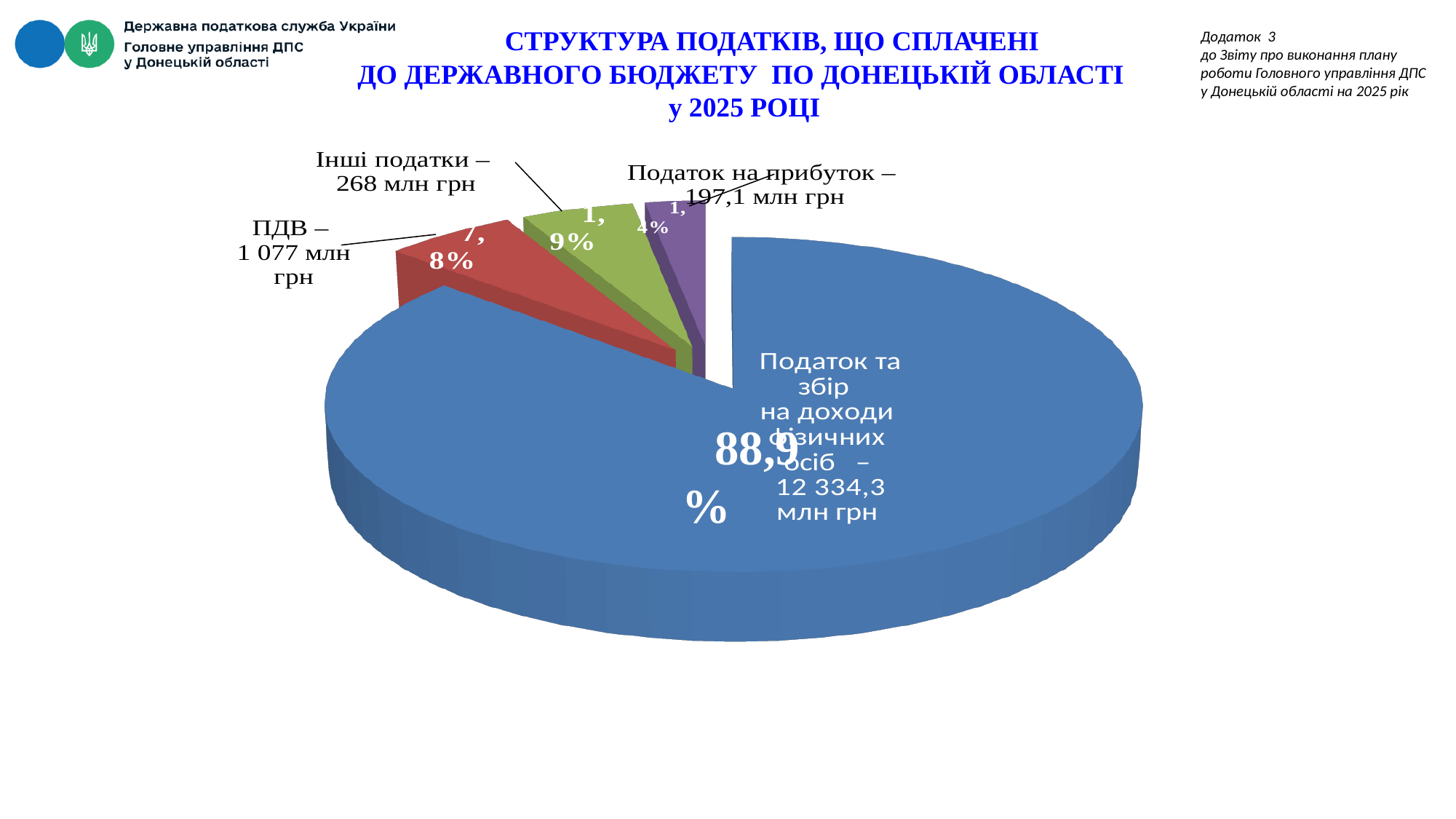
Which is larger: the amount for "Інші податки" or for "Податок на прибуток"? Інші податки What share of the pie does "Інші податки" hold? 1,9% What amount in млн грн is shown for "Інші податки"? 268 млн грн What share of the pie does "Податок та збір на доходи фізичних осіб" hold? 88,9% What share of the pie does "Податок на прибуток" hold? 1,4% What amount in млн грн is shown for "ПДВ"? 1 077 млн грн What amount in млн грн is shown for "Податок та збір на доходи фізичних осіб"? 12 334,3 млн грн How many slices does the pie chart have? 4 Which category has the smallest slice of the pie? Податок на прибуток Which category has the largest slice of the pie? Податок та збір на доходи фізичних осіб What kind of chart is shown on the slide? Pie chart